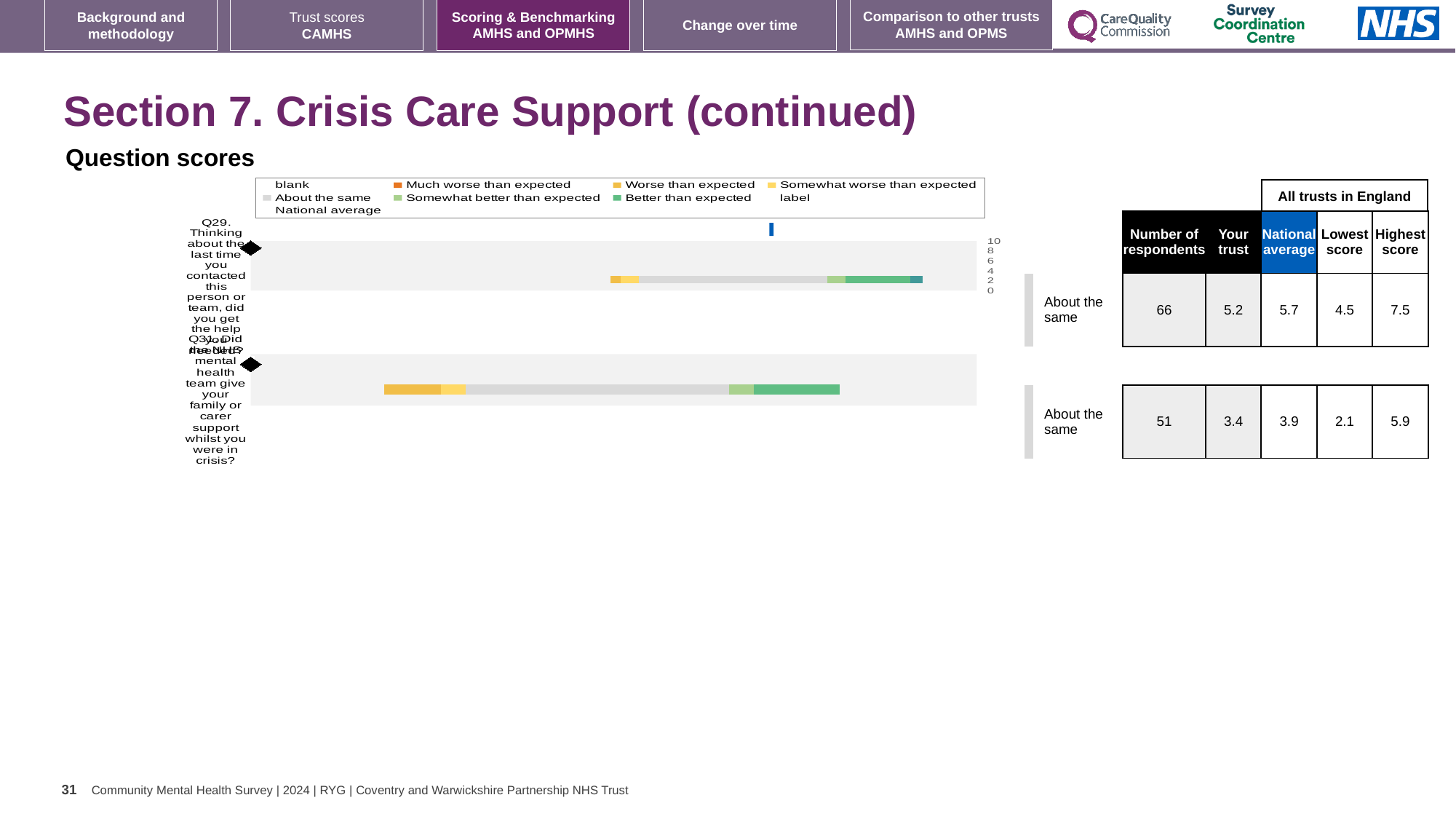
What benchmark category is shown next to both Q29 and Q31 in the table beside the chart? About the same In the table beside the chart, what is the highest score for Q31? 5.9 How many survey questions are plotted in the question scores chart? 2 What colour represents 'Better than expected' in the question scores chart legend? green In the table beside the chart, what is the difference between the highest score and the lowest score for Q29? 3.0 Which survey question is plotted in the top row of the question scores chart? Q29 In the table beside the chart, what is the national average for Q31? 3.9 What kind of chart is used to show the question scores on this slide? bar chart In the table beside the chart, what is the 'Your trust' score for Q29? 5.2 In the table beside the chart, which has the larger 'Your trust' score, Q29 or Q31? Q29 How many entries does the legend of the question scores chart list? 9 In the table beside the chart, what is the number of respondents for Q29? 66